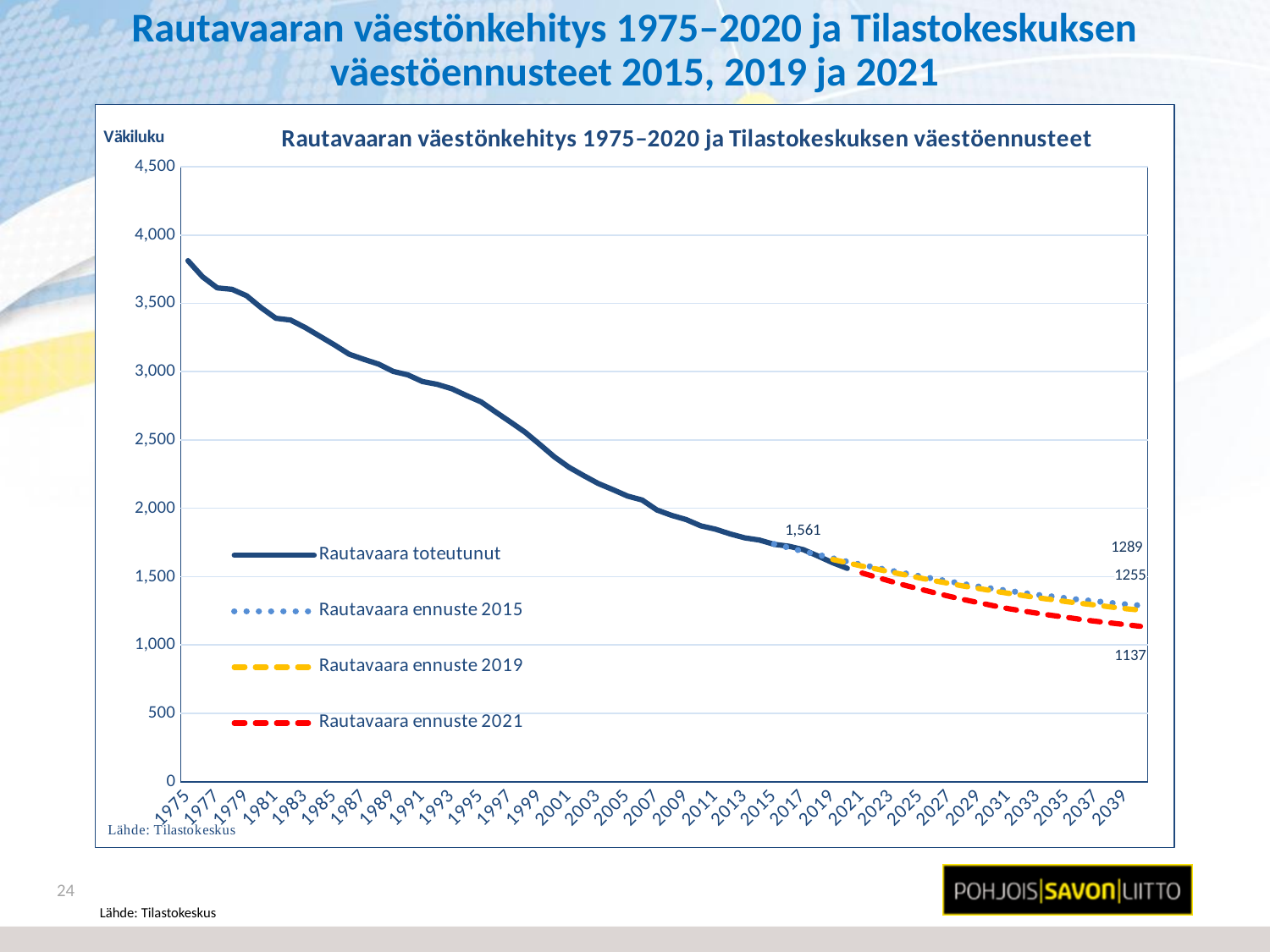
Is the value for Rautavaara toteutunut in 1975 greater or less than 3,500? greater How many series does the legend list? 4 Does the Rautavaara toteutunut series rise or fall from 1975 to 2020? fall What is the difference between the final values of the ennuste 2015 series (1289) and the ennuste 2021 series (1137)? 152 What is the final labelled value of the Rautavaara ennuste 2015 series? 1289 What label is shown on the vertical axis of the chart? Väkiluku What is the final labelled value of the Rautavaara ennuste 2021 series? 1137 Which forecast series ends at the lowest value? Rautavaara ennuste 2021 What kind of chart is shown on the slide? line chart Which forecast series ends at the highest value? Rautavaara ennuste 2015 What is the final labelled value of the Rautavaara ennuste 2019 series? 1255 What value is labelled on the chart near the year 2015? 1,561